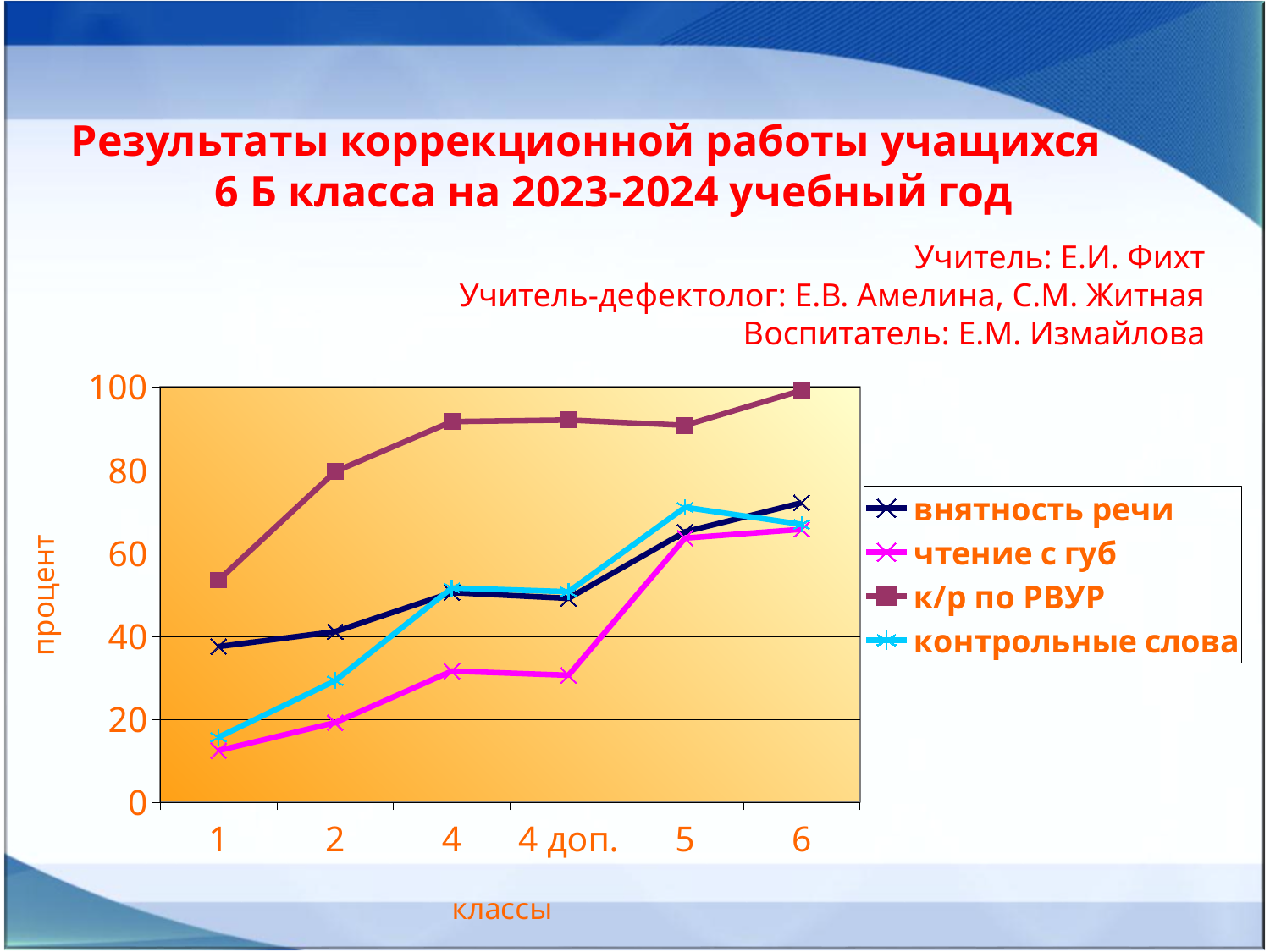
What kind of chart is shown on the slide? line chart Is the value for чтение с губ at class 1 greater or less than 20? less What is the label of the vertical axis? процент Is the value for контрольные слова at class 5 greater or less than 60? greater Is the value for внятность речи at class 1 greater or less than 40? less How many series does the legend list? 4 At class 2, which is larger: внятность речи or контрольные слова? внятность речи Do the values for к/р по РВУР generally rise or fall from class 1 to class 6? rise Which series has the lowest value at class 1? чтение с губ How many categories are shown on the x axis? 6 Which series has the highest value at class 6? к/р по РВУР